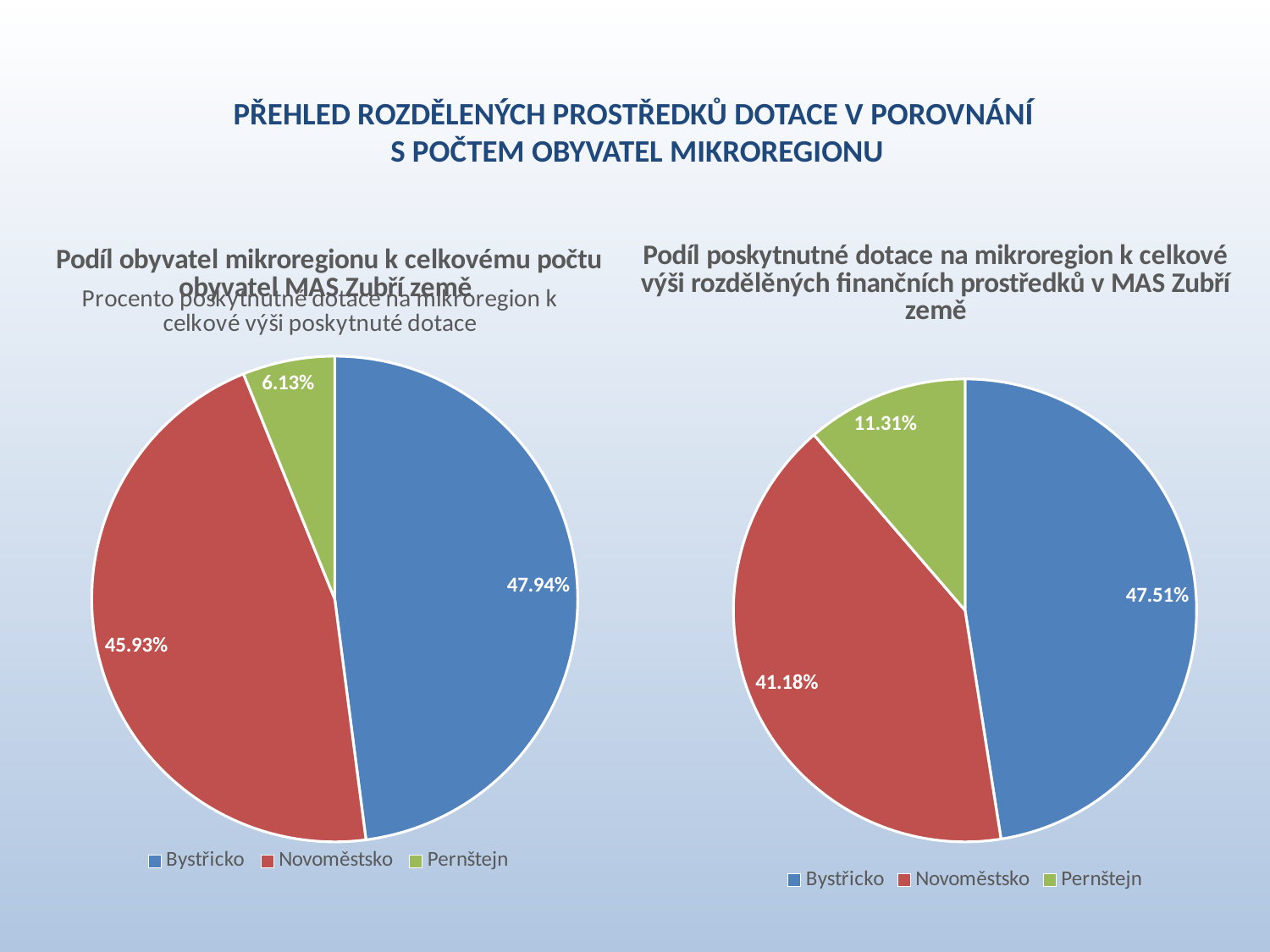
In the left pie chart, what is the value for Pernštejn? 6.13% In the right pie chart, which colour represents Pernštejn? green What kind of chart is the chart on the left of the slide? pie chart In the right pie chart, what is the value for Novoměstsko? 41.18% In the left pie chart, which category has the smallest share? Pernštejn In the left pie chart, what is the value for Bystřicko? 47.94% In the right pie chart, what is the difference between the values for Bystřicko and Novoměstsko? 6.33% How many slices does the right pie chart have? 3 In the right pie chart, what is the value for Pernštejn? 11.31% In the right pie chart, which category has the largest share? Bystřicko In the right pie chart, which is larger, the value for Novoměstsko or the value for Pernštejn? Novoměstsko In the left pie chart, what is the difference between the values for Novoměstsko and Pernštejn? 39.80%